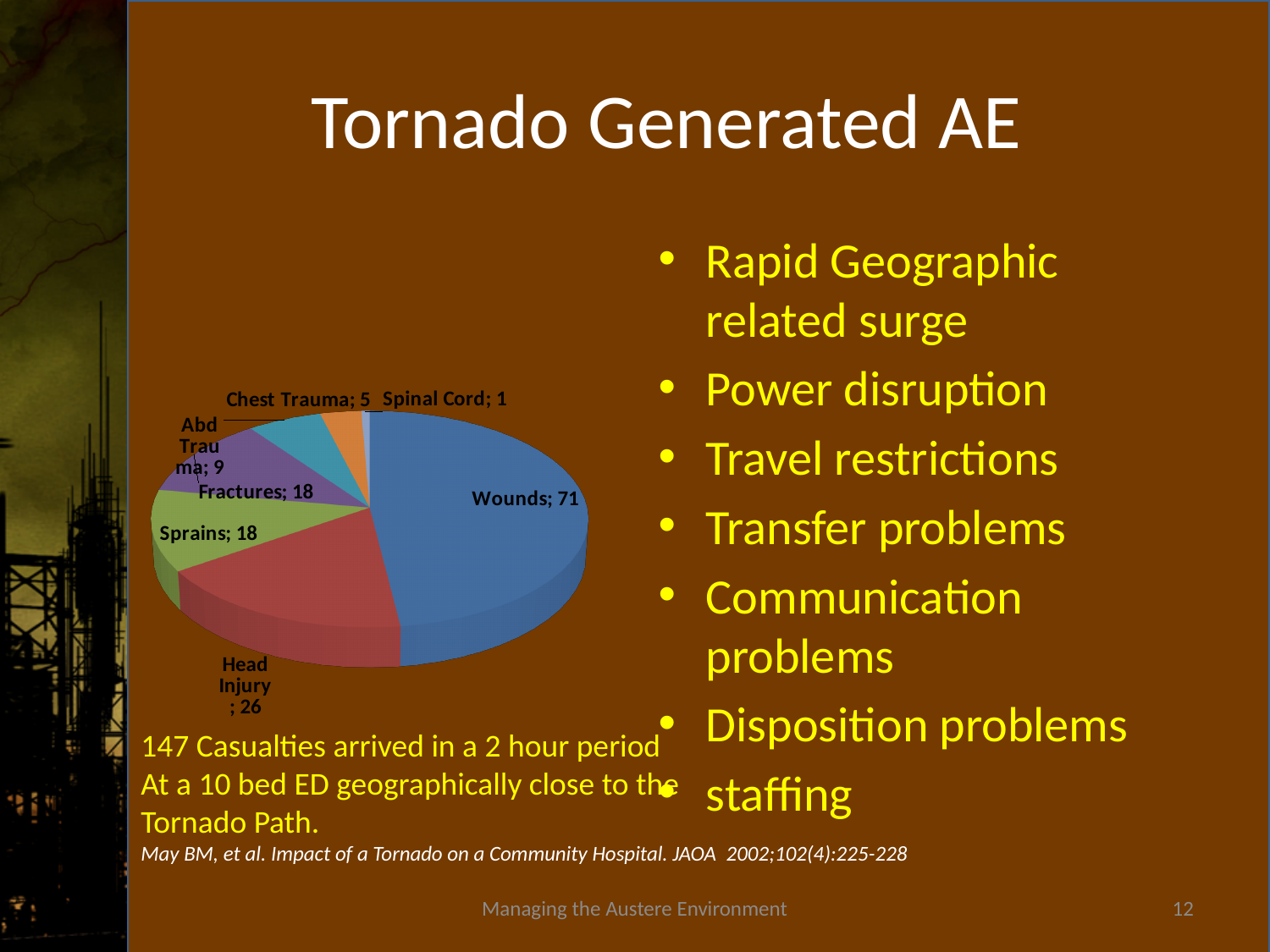
What kind of chart is shown on the slide? Pie chart What is the value shown for Chest Trauma in the pie chart? 5 What is the title of the slide containing the pie chart? Tornado Generated AE Which is larger in the pie chart, Head Injury or Fractures? Head Injury What is the difference between the values for Sprains and Chest Trauma? 13 Which injury category has the largest slice in the pie chart? Wounds How many injury categories does the pie chart show? 7 What is the value shown for Head Injury in the pie chart? 26 What is the difference between the values for Wounds and Head Injury? 45 What is the value shown for Wounds in the pie chart? 71 What is the value shown for Abd Trauma in the pie chart? 9 Which injury category has the smallest slice in the pie chart? Spinal Cord